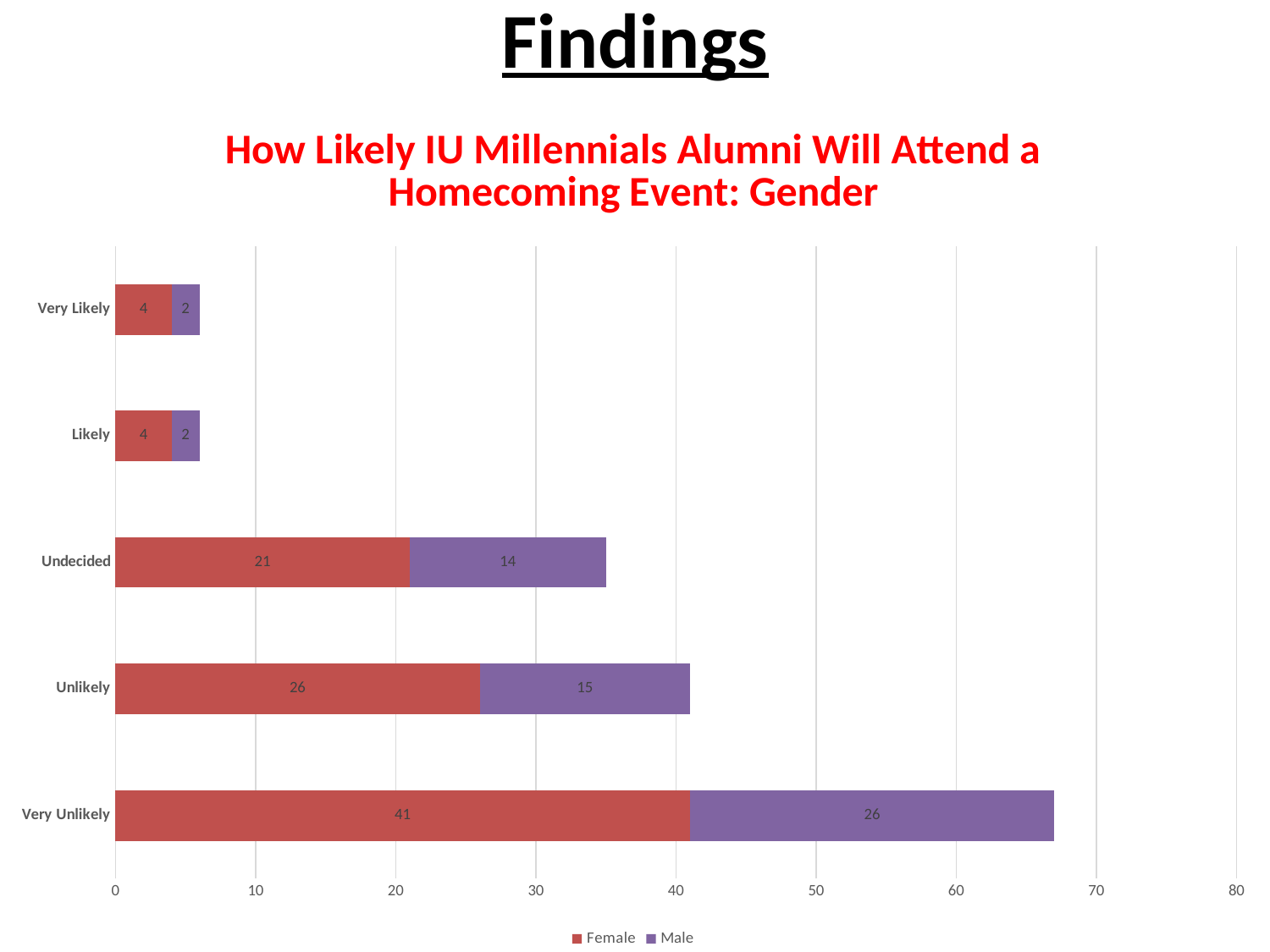
Is the Female value for Unlikely larger than the Female value for Undecided? Yes What is the Female value for Very Unlikely? 41 How many series does the legend list? 2 What is the total of the stacked bar for Very Unlikely? 67 What kind of chart is shown? Stacked bar chart What is the total of the stacked bar for Undecided? 35 Which category has the lowest Male value? Very Likely and Likely (both 2) What is the Male value for Unlikely? 15 How many categories are shown on the chart? 5 What is the difference between the Female and Male values for Very Unlikely? 15 What is the Male value for Undecided? 14 Which category has the highest Female value? Very Unlikely